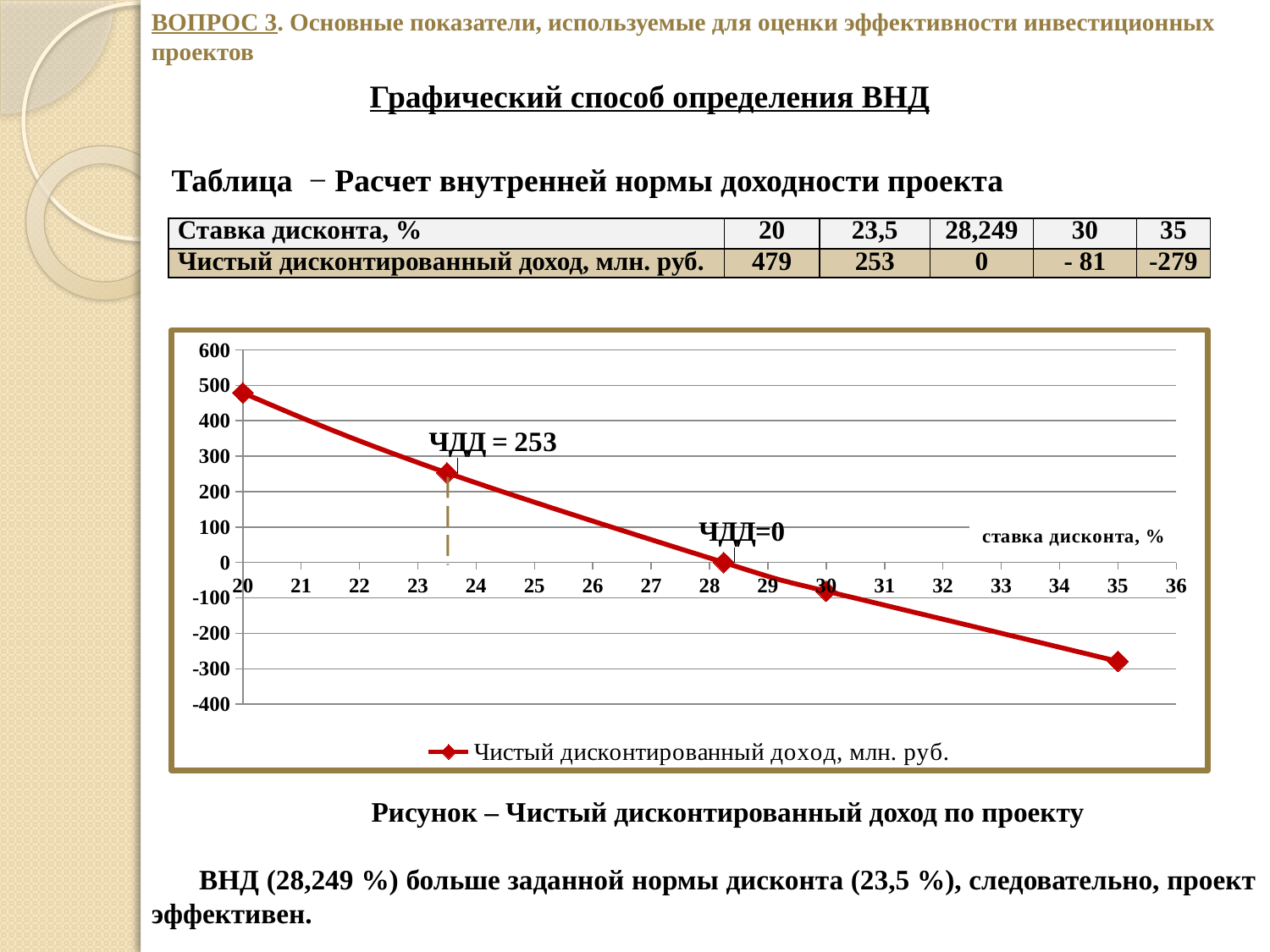
What kind of chart is shown on the slide? line chart How many data points are plotted on the line? 5 At which discount rate is the net discounted income highest? 20 At which discount rate is the net discounted income lowest? 35 What is the difference between the net discounted income at 20% and at 23.5%? 226 How many series does the chart legend list? 1 What is the net discounted income at a discount rate of 35%? -279 What is the net discounted income (ЧДД) at a discount rate of 23.5%, as labelled on the chart? 253 What is the net discounted income (ЧДД) at a discount rate of 28.249%? 0 What is the net discounted income at a discount rate of 20%? 479 Is the value at a discount rate of 30% greater or less than 0? less Do the values rise or fall as the discount rate increases along the x axis? fall